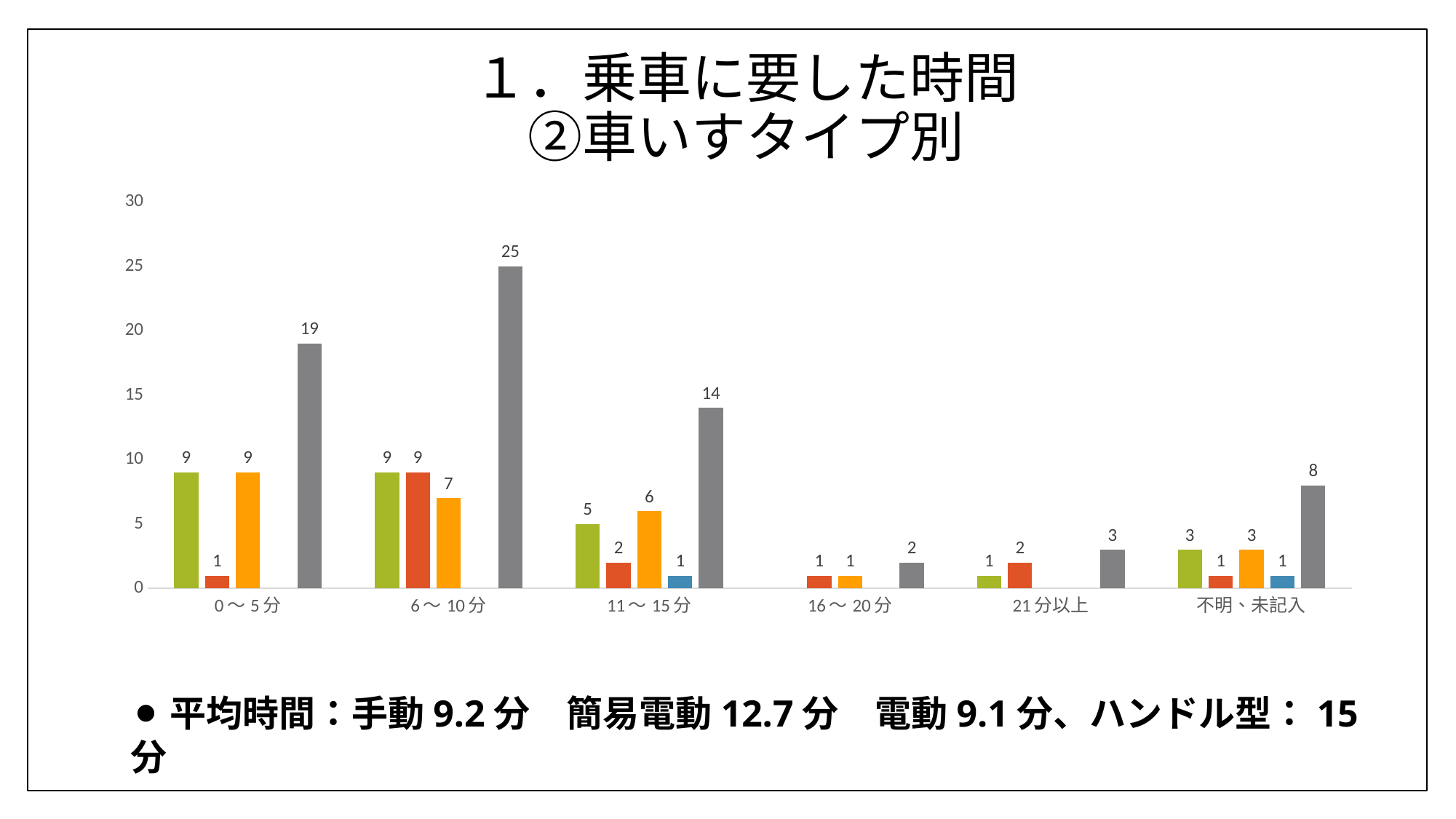
What is the value of the gray bar for the 0～5分 category? 19 Which is larger: the orange bar for 6～10分 or the orange bar for 11～15分? 6～10分 What is the title of the slide containing the chart? １．乗車に要した時間 ②車いすタイプ別 What is the difference between the gray bar values for 6～10分 and 11～15分? 11 Is the gray bar for 0～5分 greater or less than 15? greater How many categories are shown on the x axis? 6 In which category is the gray bar lowest? 16～20分 What is the value of the gray bar for the 6～10分 category? 25 In which category does the gray bar reach its highest value? 6～10分 What is the value of the gray bar for the 不明、未記入 category? 8 What is the value of the green bar for the 11～15分 category? 5 What type of chart is shown on the slide? Bar chart